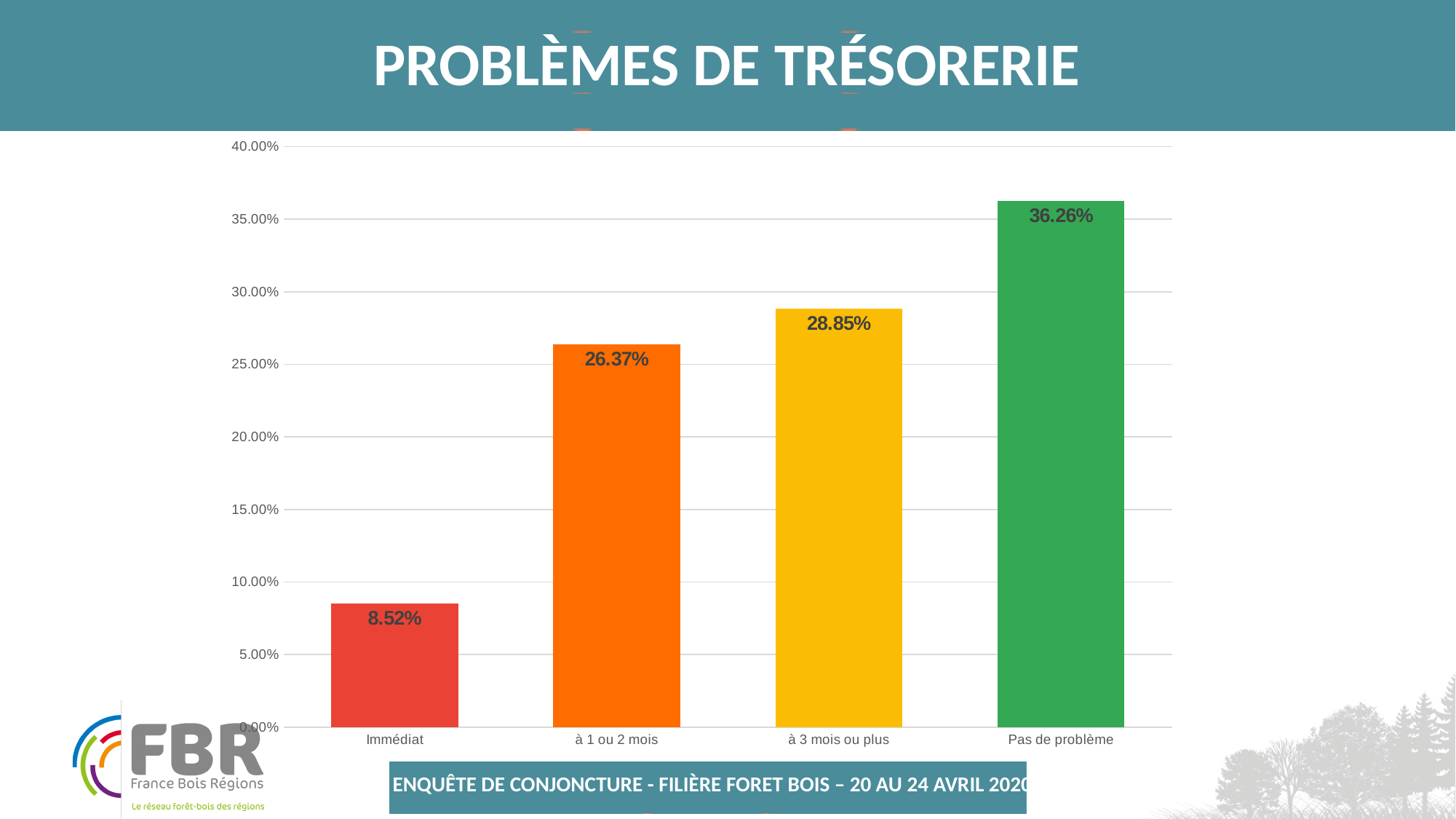
What kind of chart is shown on the slide? Bar chart Which category has the lowest value? Immédiat What is the value for "à 3 mois ou plus"? 28.85% How many categories are shown on the chart? 4 What is the value for "Immédiat"? 8.52% What is the difference between the values for "Pas de problème" and "Immédiat"? 27.74% What is the value for "Pas de problème"? 36.26% Is the value for "Pas de problème" greater or less than 35.00%? greater What is the difference between the values for "à 3 mois ou plus" and "à 1 ou 2 mois"? 2.48% What is the value for "à 1 ou 2 mois"? 26.37% Which is larger, the value for "à 1 ou 2 mois" or the value for "Immédiat"? à 1 ou 2 mois Which category has the highest value? Pas de problème